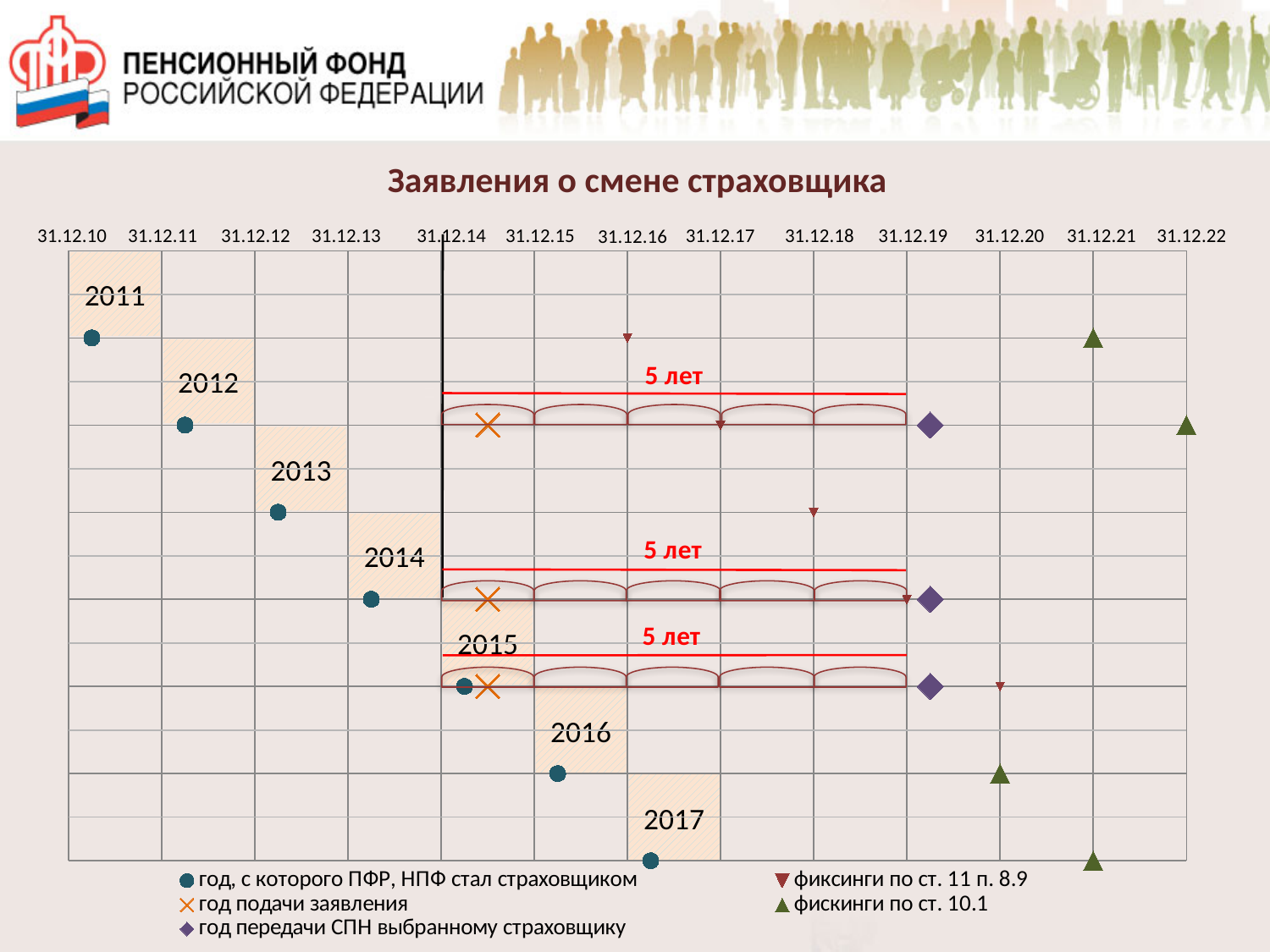
What is the last date label on the chart's axis? 31.12.22 Which legend entry is represented by the orange X marker? год подачи заявления At which date label do the purple diamond markers (год передачи СПН выбранному страховщику) appear? 31.12.19 How many year labels (2011, 2012, ...) are placed on the chart grid? 7 What is the first date label on the chart's axis? 31.12.10 How many entries does the chart legend list? 5 What is the earliest year label shown on the chart grid? 2011 What is the title of the chart? Заявления о смене страховщика How many date labels are shown along the top axis of the chart? 13 What is the latest year label shown on the chart grid? 2017 How many times does the label '5 лет' appear on the chart? 3 At which date label is the vertical black line on the chart drawn? 31.12.14